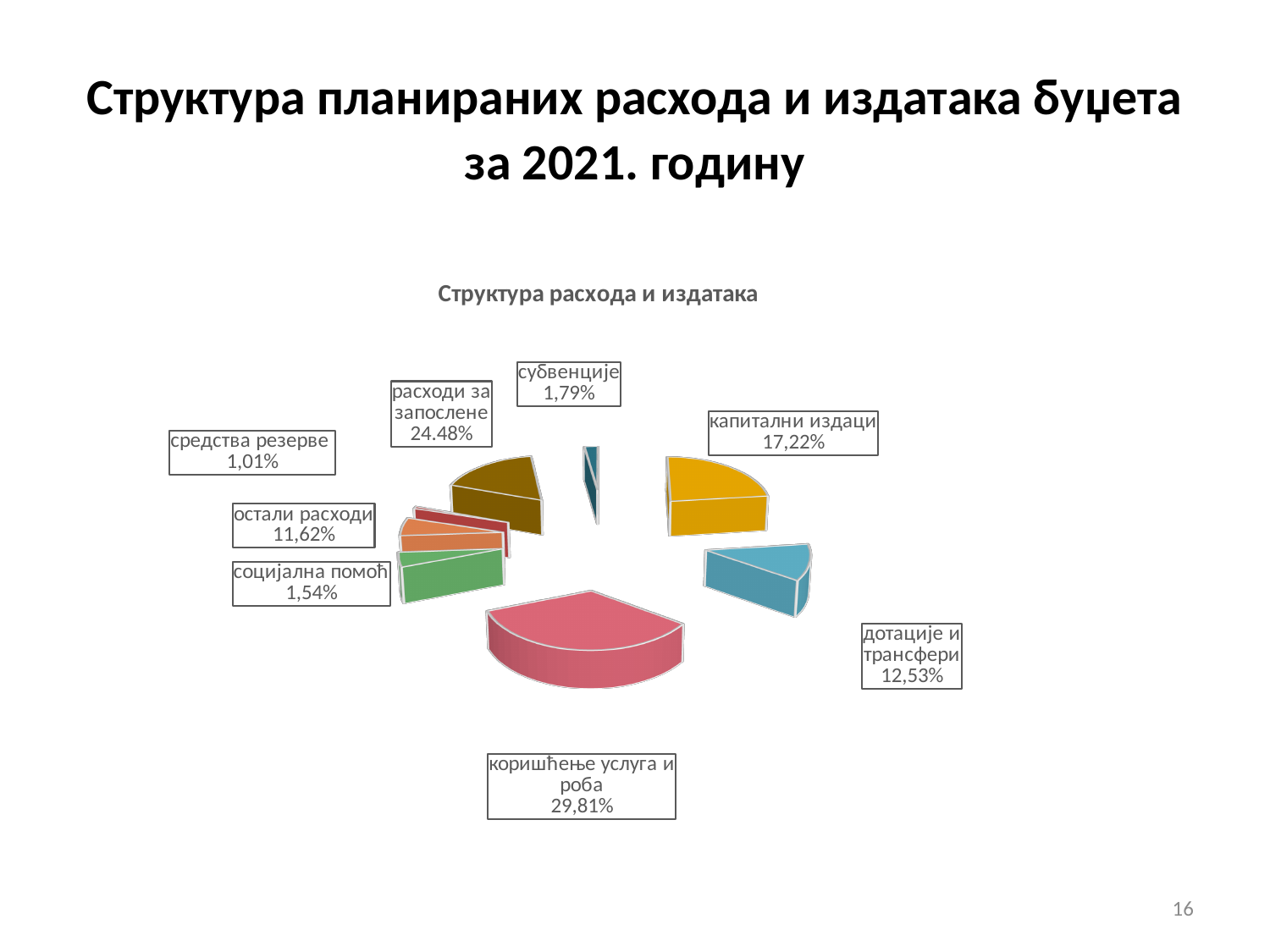
What share is shown for дотације и трансфери? 12,53% Which category has the smallest share of the pie? средства резерве What is the chart's title? Структура расхода и издатака What share is shown for расходи за запослене? 24.48% Which category has the largest share of the pie? коришћење услуга и роба What is the difference between the shares for капитални издаци and дотације и трансфери? 4,69% How many slices does the pie chart have? 8 Which is larger, the share for остали расходи or the share for дотације и трансфери? дотације и трансфери What kind of chart is shown on the slide? pie chart What share is shown for капитални издаци? 17,22% What share is shown for коришћење услуга и роба? 29,81% What share is shown for средства резерве? 1,01%